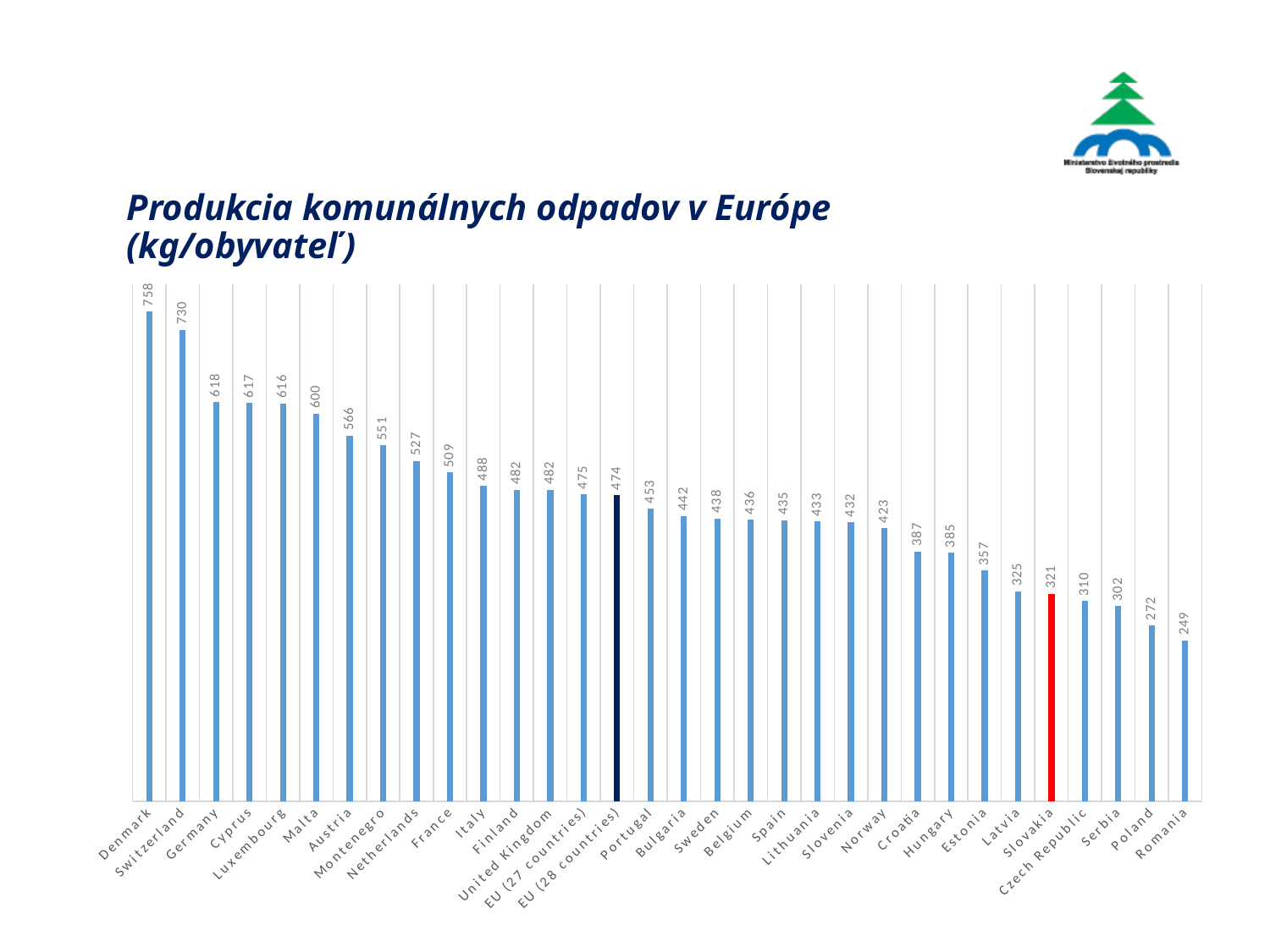
Which is larger, the value for Austria or the value for Montenegro? Austria What is the value for EU (28 countries)? 474 What is the difference between the values for Slovakia and Czech Republic? 11 Which is larger, the value for Poland or the value for Serbia? Serbia How many categories are shown on the x axis? 32 What is the value for Denmark? 758 What is the value for Slovakia? 321 What kind of chart is shown on the slide? Bar chart Which category has the lowest value? Romania Which category has the highest value? Denmark What is the difference between the values for Denmark and Romania? 509 Which category's bar is coloured red? Slovakia